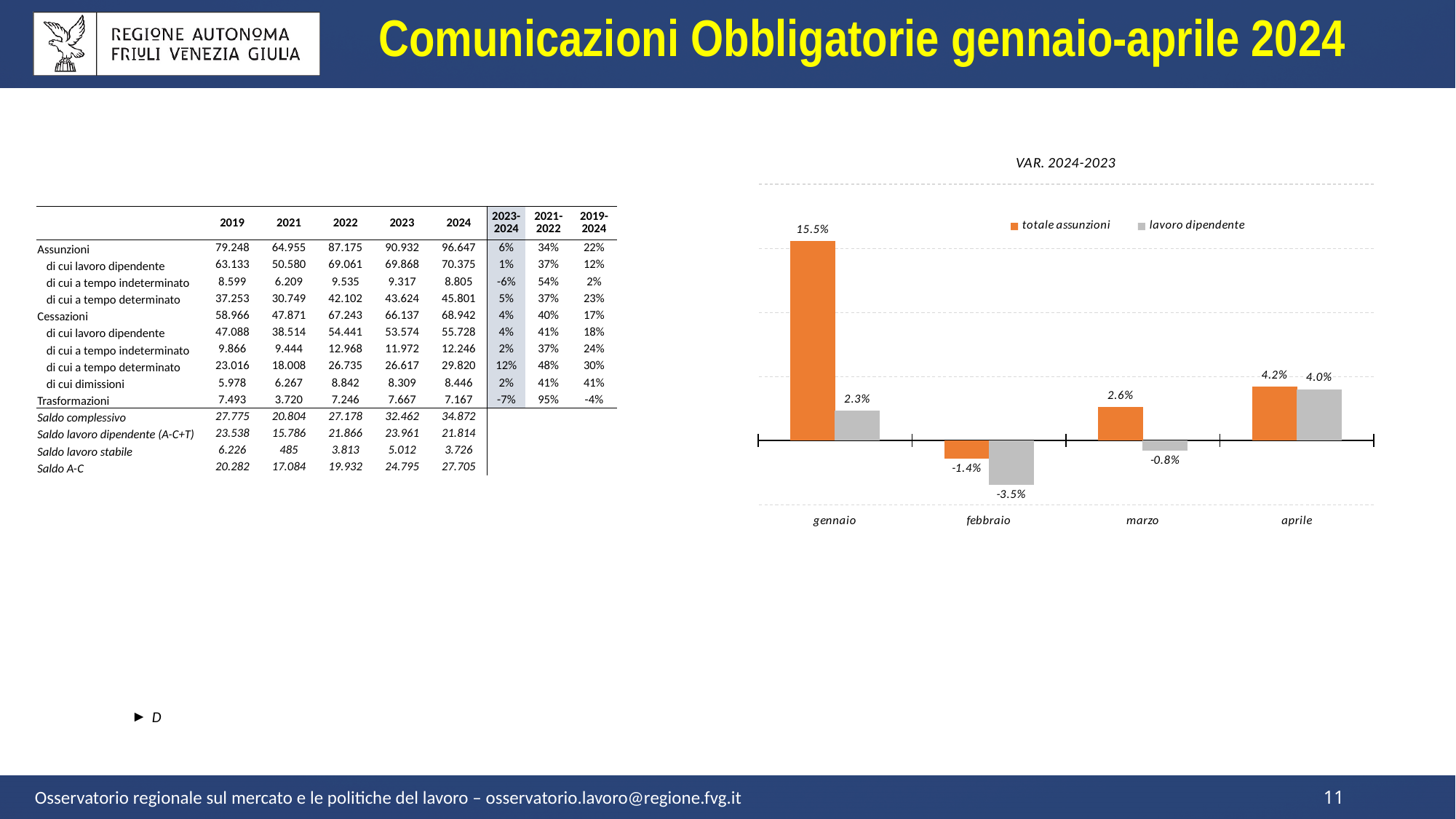
What is the value for lavoro dipendente in febbraio? -3.5% Which month has the highest value for totale assunzioni? gennaio In marzo, which is larger: totale assunzioni or lavoro dipendente? totale assunzioni What kind of chart is shown on the slide? bar chart How many months are shown on the x axis of the chart? 4 What is the difference between totale assunzioni and lavoro dipendente in gennaio? 13.2% Which month has the lowest value for lavoro dipendente? febbraio How many series does the chart legend list? 2 What is the value for lavoro dipendente in marzo? -0.8% What is the value for totale assunzioni in aprile? 4.2% What is the value for totale assunzioni in gennaio? 15.5% What is the title of the chart? VAR. 2024-2023